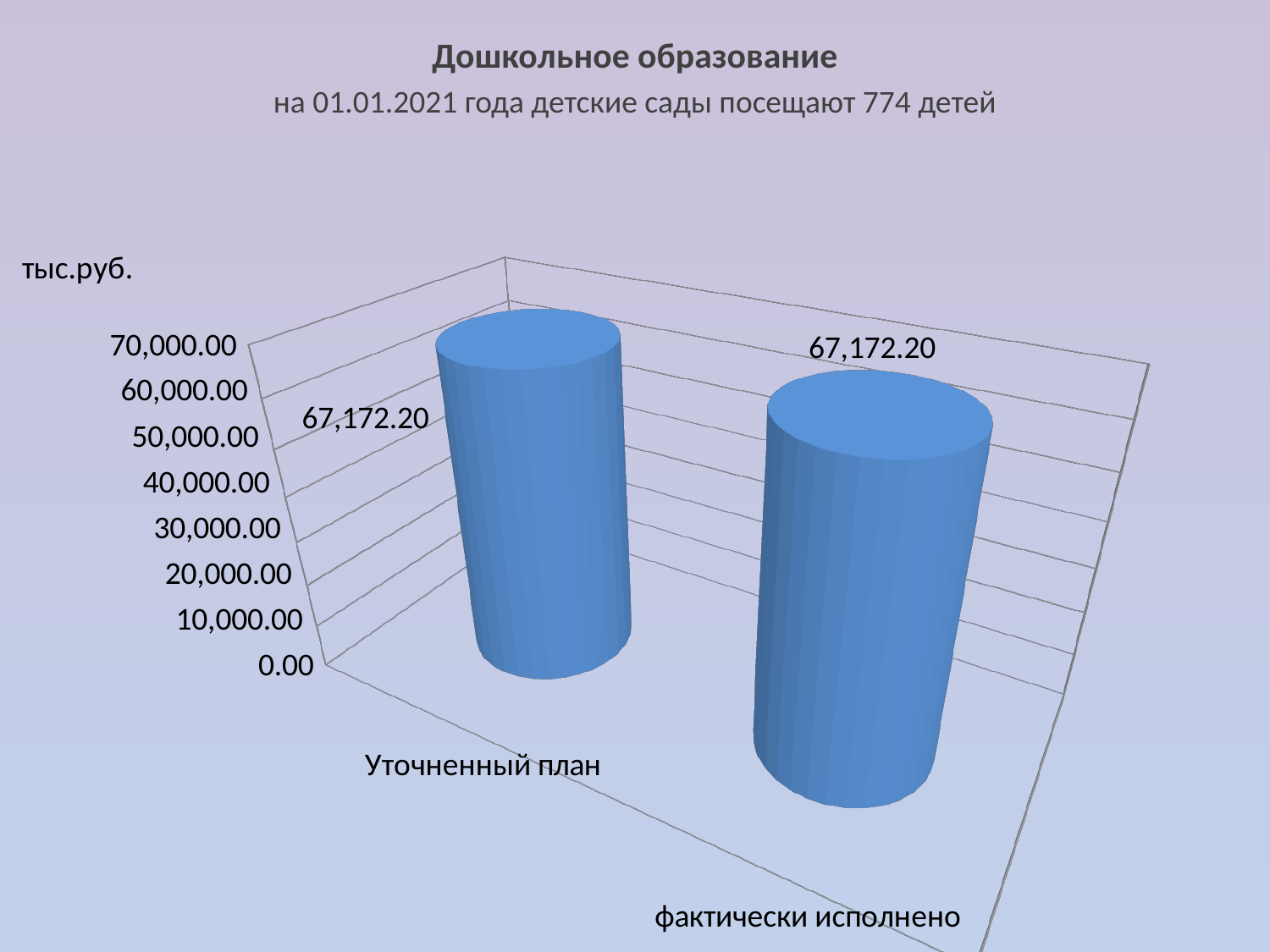
What is the highest tick value shown on the vertical axis? 70,000.00 What is the title of the chart on the slide? Дошкольное образование What kind of chart is shown on the slide? bar chart What is the value for Уточненный план? 67,172.20 How many categories are plotted on the chart? 2 What is the difference between the value for Уточненный план and the value for фактически исполнено? 0.00 What unit is shown for the vertical axis of the chart? тыс.руб. Is the value for Уточненный план greater or less than 70,000.00? less What is the value for фактически исполнено? 67,172.20 Is the value for фактически исполнено greater or less than 60,000.00? greater